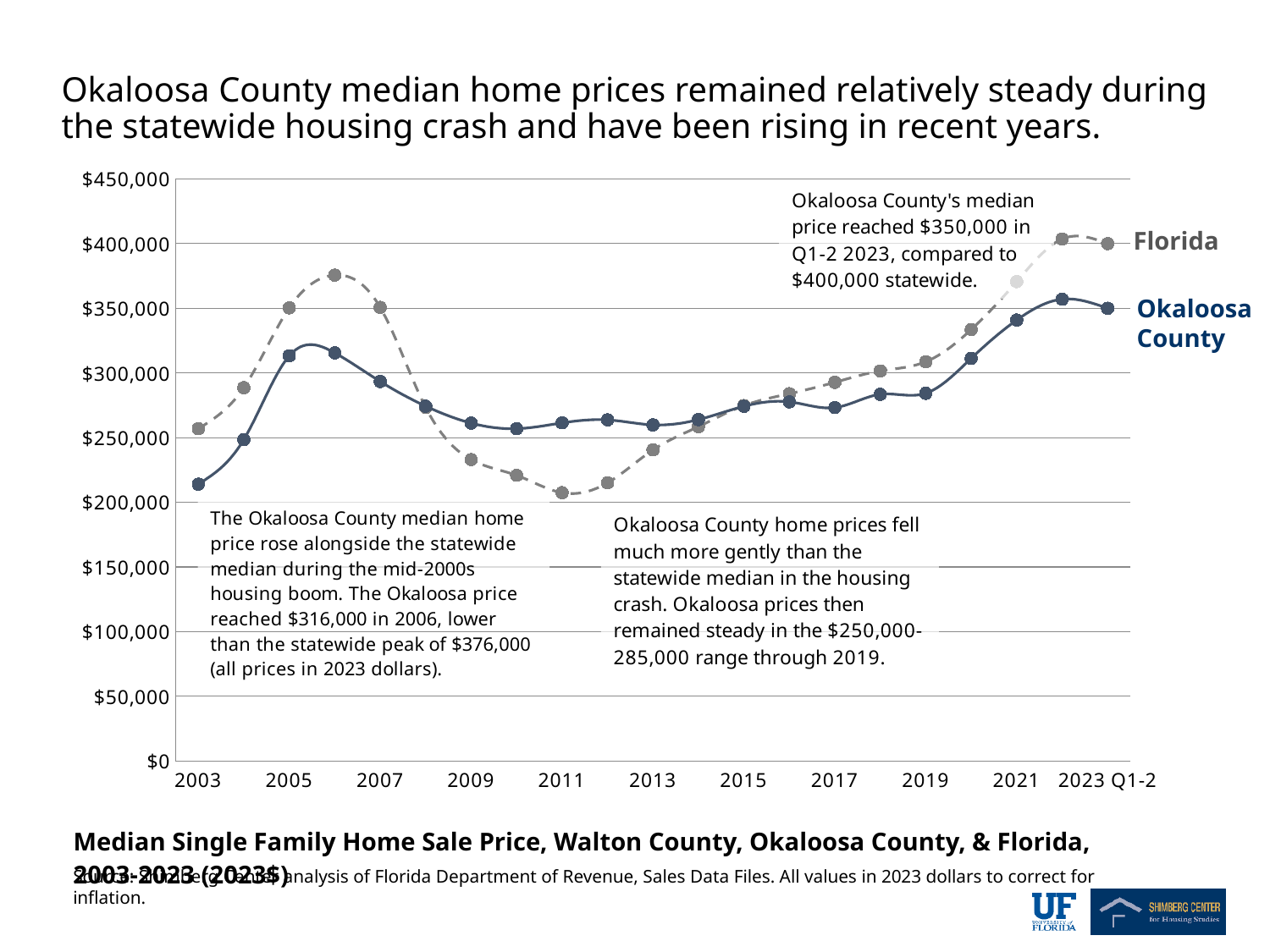
Is the Florida value for 2011 greater or less than $250,000? less Which series is drawn with a dashed line, Florida or Okaloosa County? Florida How many series are plotted on the chart? 2 According to the annotation, what was the statewide median price in Q1-2 2023? $400,000 In 2011, which series has the higher value, Florida or Okaloosa County? Okaloosa County Is the Okaloosa County value for 2003 greater or less than $250,000? less What is the difference between the statewide and Okaloosa County median prices in Q1-2 2023, as stated in the annotation? $50,000 Does the Okaloosa County line rise or fall between 2019 and 2022? rise In which year did the Florida median price reach its peak? 2022 According to the annotation, what was the Okaloosa County median price in 2006? $316,000 What type of chart is shown on the slide? line chart According to the annotation, what was Okaloosa County's median price in Q1-2 2023? $350,000